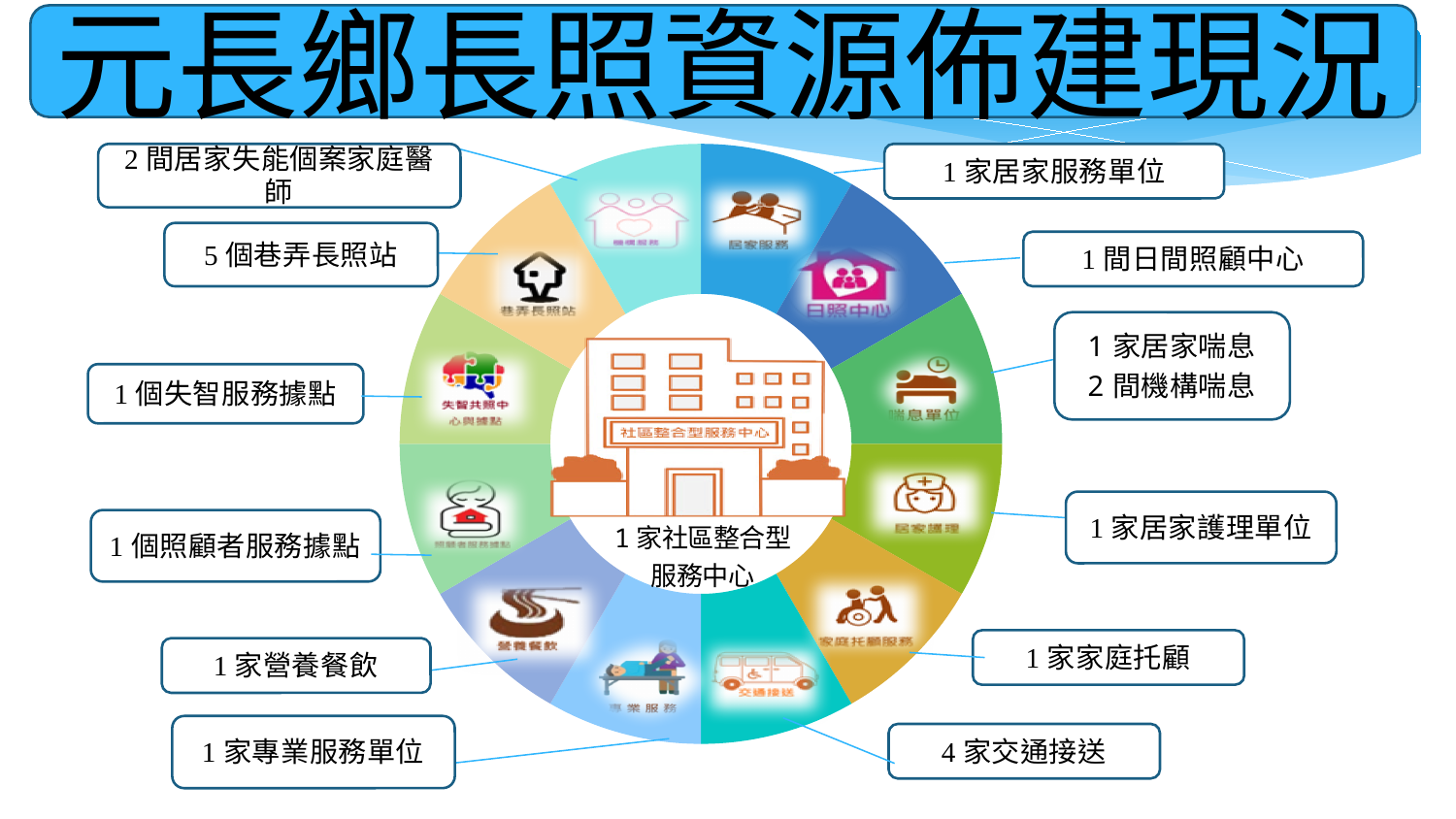
Which resource type has the highest count on the slide? 巷弄長照站 What is shown in the centre of the ring diagram? 1 家社區整合型服務中心 How many 交通接送 providers are shown on the slide? 4 家 How many 居家失能個案家庭醫師 are shown on the slide? 2 間 What is the difference between the number of 巷弄長照站 and the number of 交通接送? 1 How many 巷弄長照站 are shown on the slide? 5 個 How many segments does the ring diagram contain? 12 What kind of diagram is shown on the slide? A ring (donut) diagram Which is larger, the number of 交通接送 or the number of 家庭托顧? 交通接送 How many 機構喘息 are shown on the slide? 2 間 How many 日間照顧中心 are shown on the slide? 1 間 What is the title of the slide? 元長鄉長照資源佈建現況